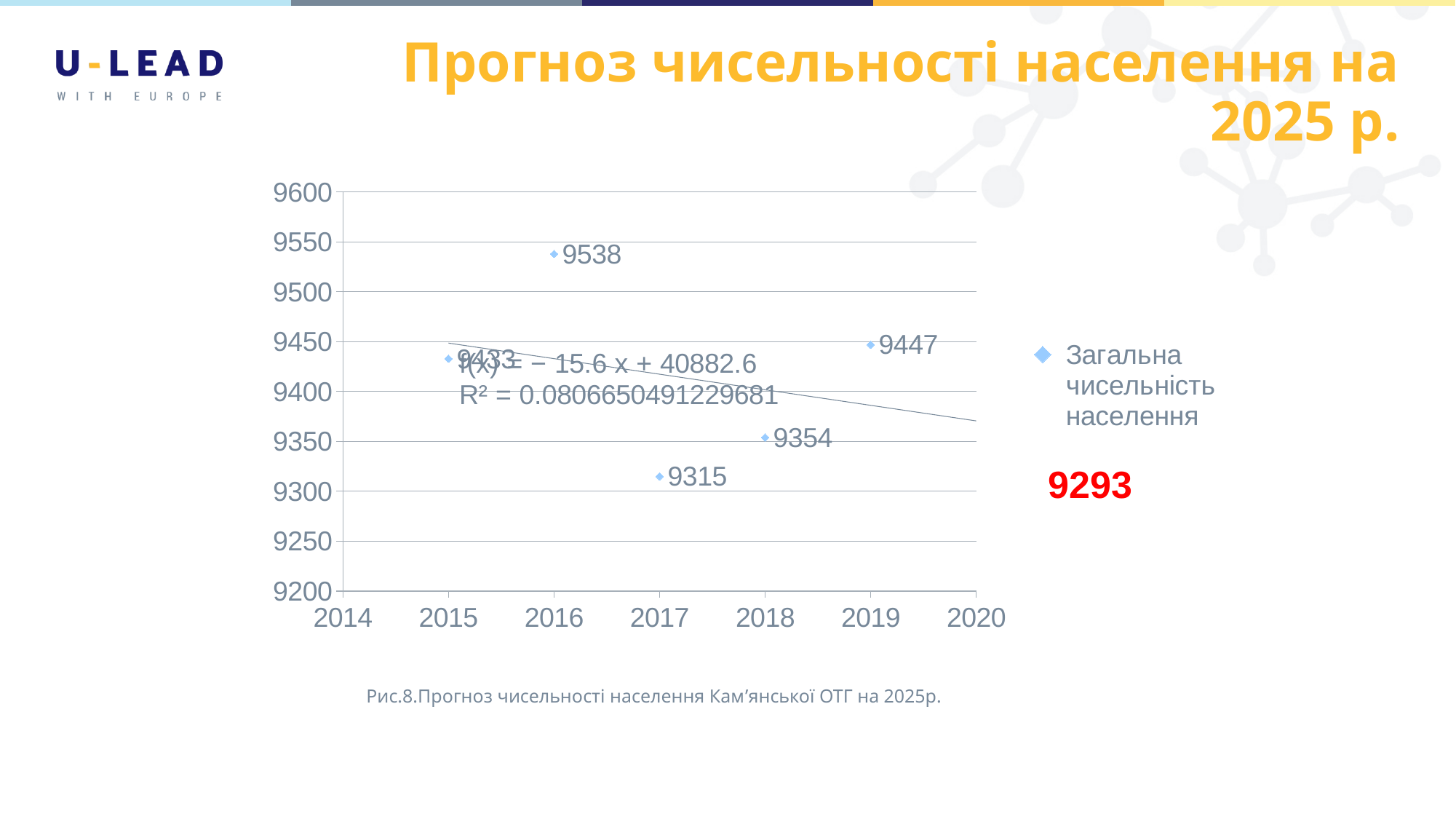
Which year has the lowest value? 2017 What is the value for 2018? 9354 What is the value for 2016? 9538 What is the difference between the values for 2016 and 2017? 223 Which is larger, the value for 2018 or the value for 2019? 2019 Is the value for 2015 greater or less than 9400? greater What is the value for 2017? 9315 How many data points are plotted in the chart? 5 What is the value for 2019? 9447 How many series does the legend list? 1 What kind of chart is shown on the slide? scatter chart Which year has the highest value? 2016